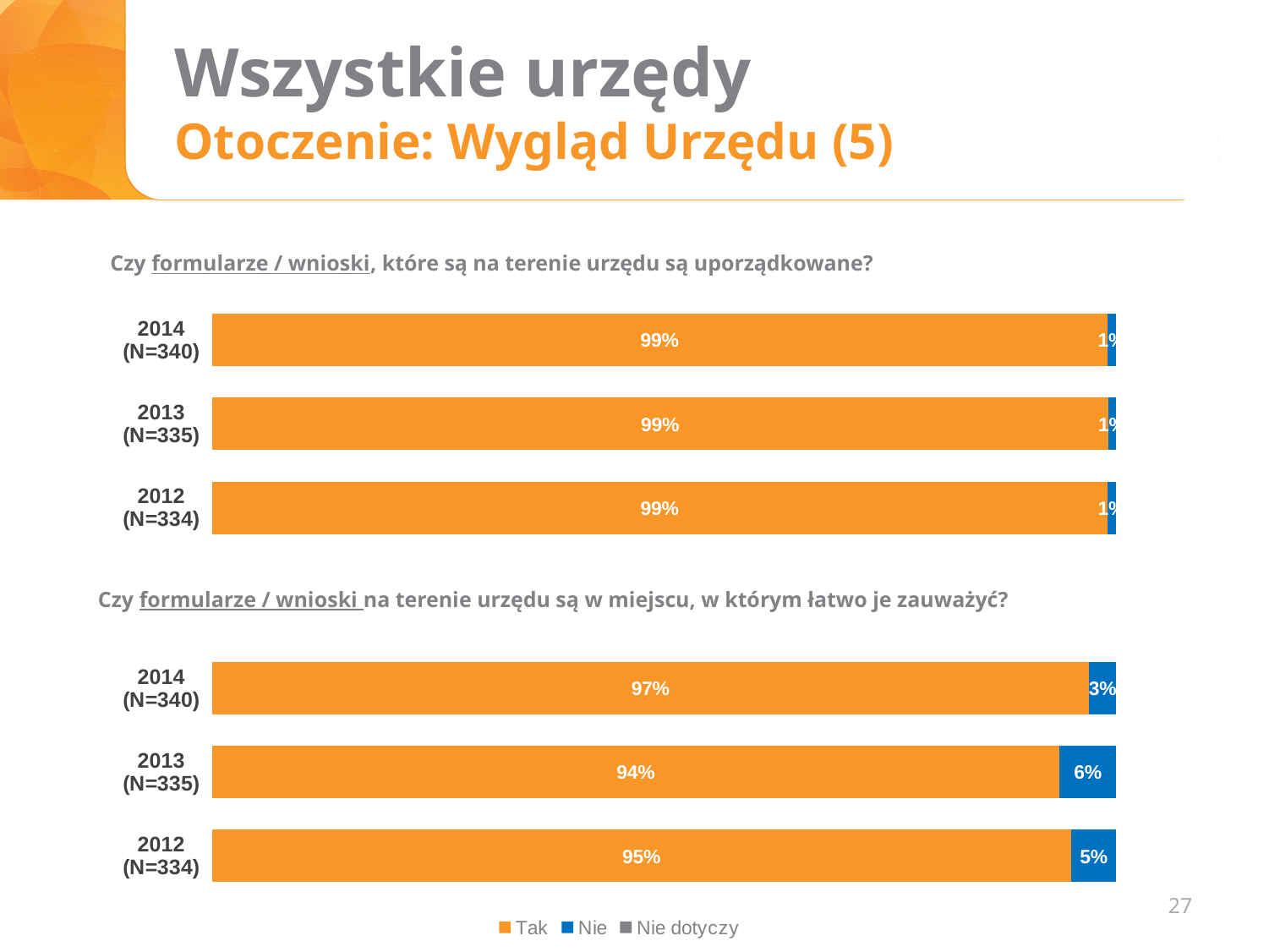
In the top chart, what is the 'Tak' value for 2013 (N=335)? 99% What type of chart is the bottom chart? Bar chart In the bottom chart, what is the difference between the 'Tak' values for 2014 and 2013? 3% In the bottom chart, what is the 'Nie' value for 2013 (N=335)? 6% How many series does the legend at the bottom of the slide list? 3 How many year categories does the top chart show? 3 In the bottom chart, which year has the lowest 'Tak' value? 2013 (N=335) In the bottom chart, what is the 'Tak' value for 2012 (N=334)? 95% In the bottom chart, what is the 'Tak' value for 2014 (N=340)? 97% In the bottom chart, is the 'Nie' value larger for 2013 or for 2012? 2013 In the bottom chart, which year has the highest 'Tak' value? 2014 (N=340) Which colour represents 'Nie' in the charts? Blue